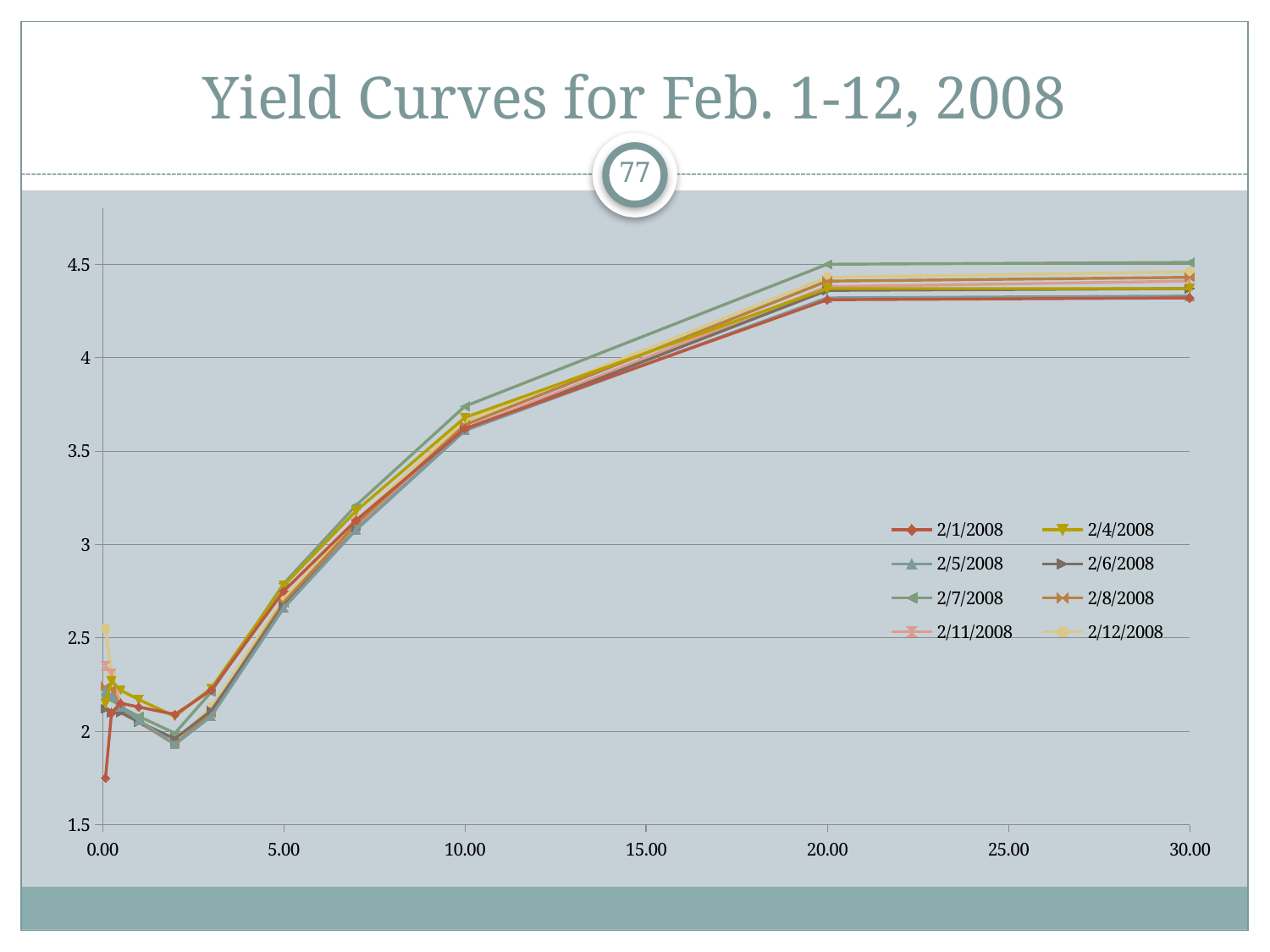
Do the yield curves generally rise or fall between 5.00 and 20.00 on the x axis? rise What is the title of the slide's chart? Yield Curves for Feb. 1-12, 2008 Which series is larger at 20.00: 2/7/2008 or 2/1/2008? 2/7/2008 Which series is lowest at the 0.00 point on the x axis? 2/1/2008 What kind of chart is shown on the slide? line chart Which series is highest at the 0.00 point on the x axis? 2/12/2008 Which series is highest at the 20.00 point on the x axis? 2/7/2008 Is the value for 2/7/2008 at 10.00 greater or less than 3.5? greater Is the value for 2/1/2008 at 20.00 greater or less than 4.5? less How many series does the legend list? 8 Is the value for 2/1/2008 at 0.00 greater or less than 2? less